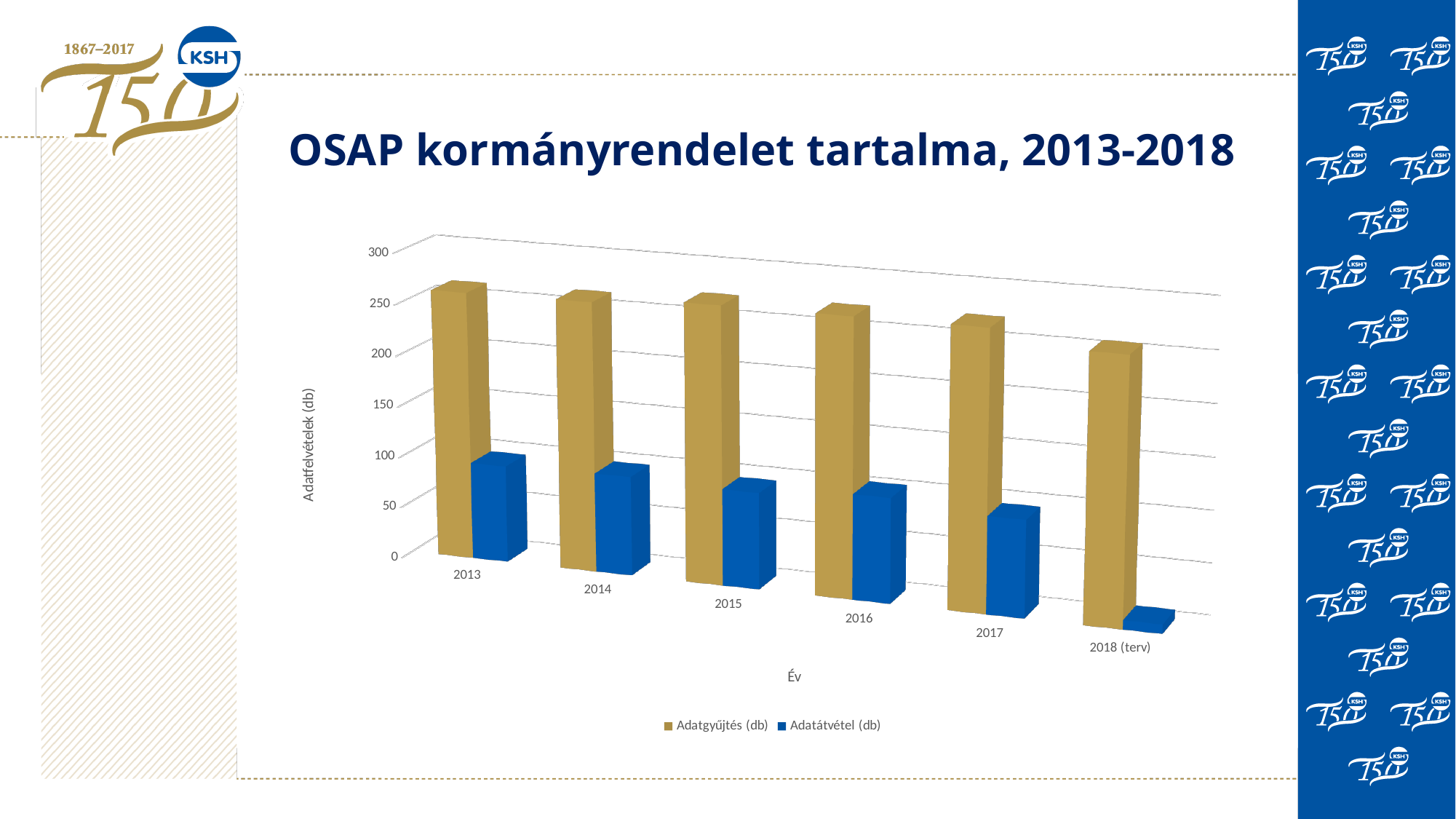
How many series does the legend list? 2 What kind of chart is shown on the slide? bar chart Is the value for Adatgyűjtés (db) in 2013 greater or less than 200? greater In 2013, which is larger: Adatgyűjtés (db) or Adatátvétel (db)? Adatgyűjtés (db) Is the value for Adatátvétel (db) in 2017 greater or less than 100? less Which year has the lowest value for Adatátvétel (db)? 2018 (terv) How many years (categories) are shown on the x axis? 6 What is the title of the chart? OSAP kormányrendelet tartalma, 2013-2018 Is the value for Adatátvétel (db) in 2018 (terv) greater or less than 50? less Which year has the lowest value for Adatgyűjtés (db)? 2018 (terv)